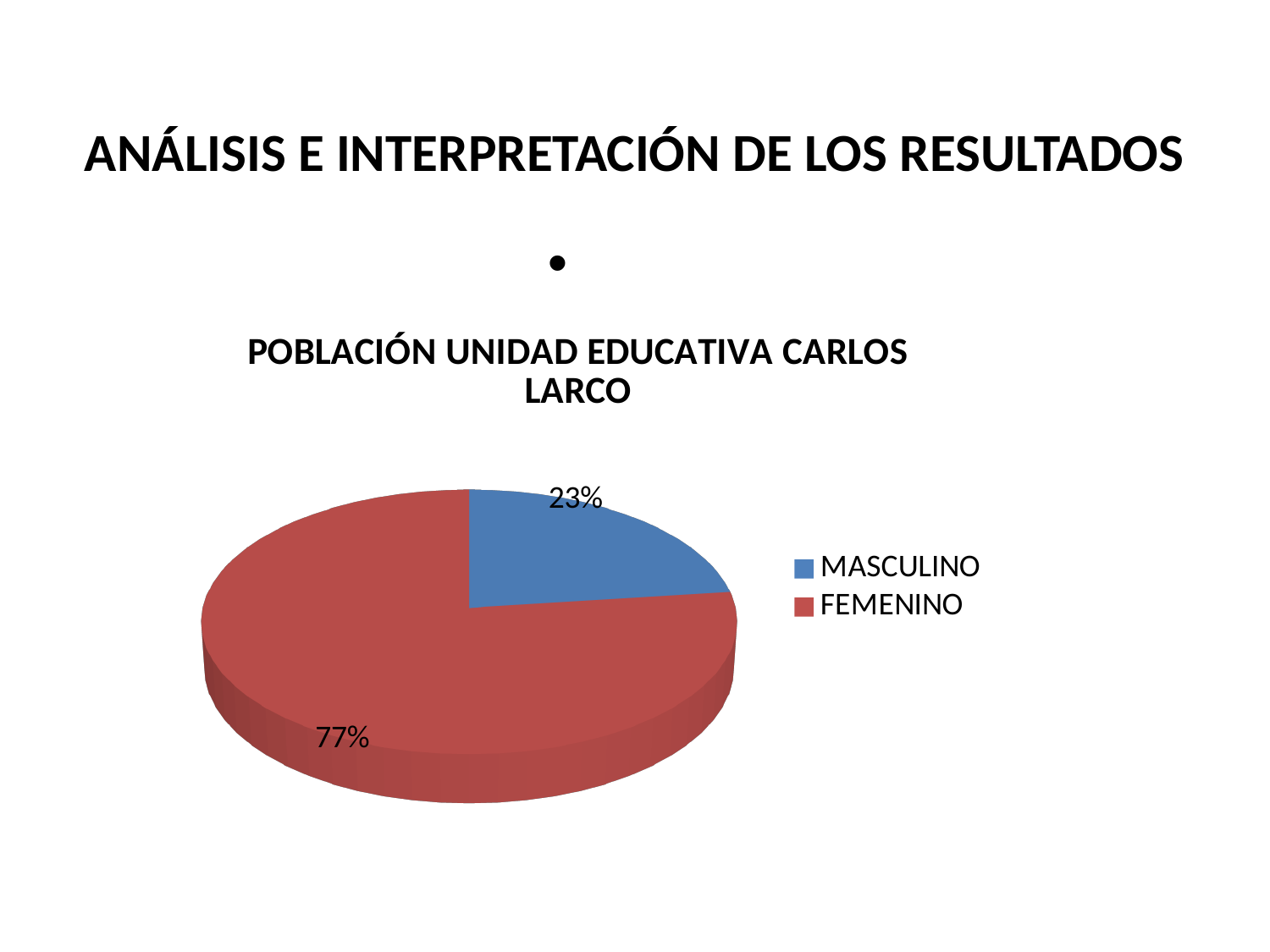
What is the difference in percentage points between FEMENINO and MASCULINO? 54 What share of the pie does FEMENINO represent? 77% What kind of chart is shown on the slide? pie chart What colour is the FEMENINO slice? red How many categories does the pie chart show? 2 Which category has the smallest slice of the pie? MASCULINO How many entries does the legend list? 2 What is the title of the chart? POBLACIÓN UNIDAD EDUCATIVA CARLOS LARCO Which category has the largest slice of the pie? FEMENINO Which is larger, the MASCULINO slice or the FEMENINO slice? FEMENINO What share of the pie does MASCULINO represent? 23%